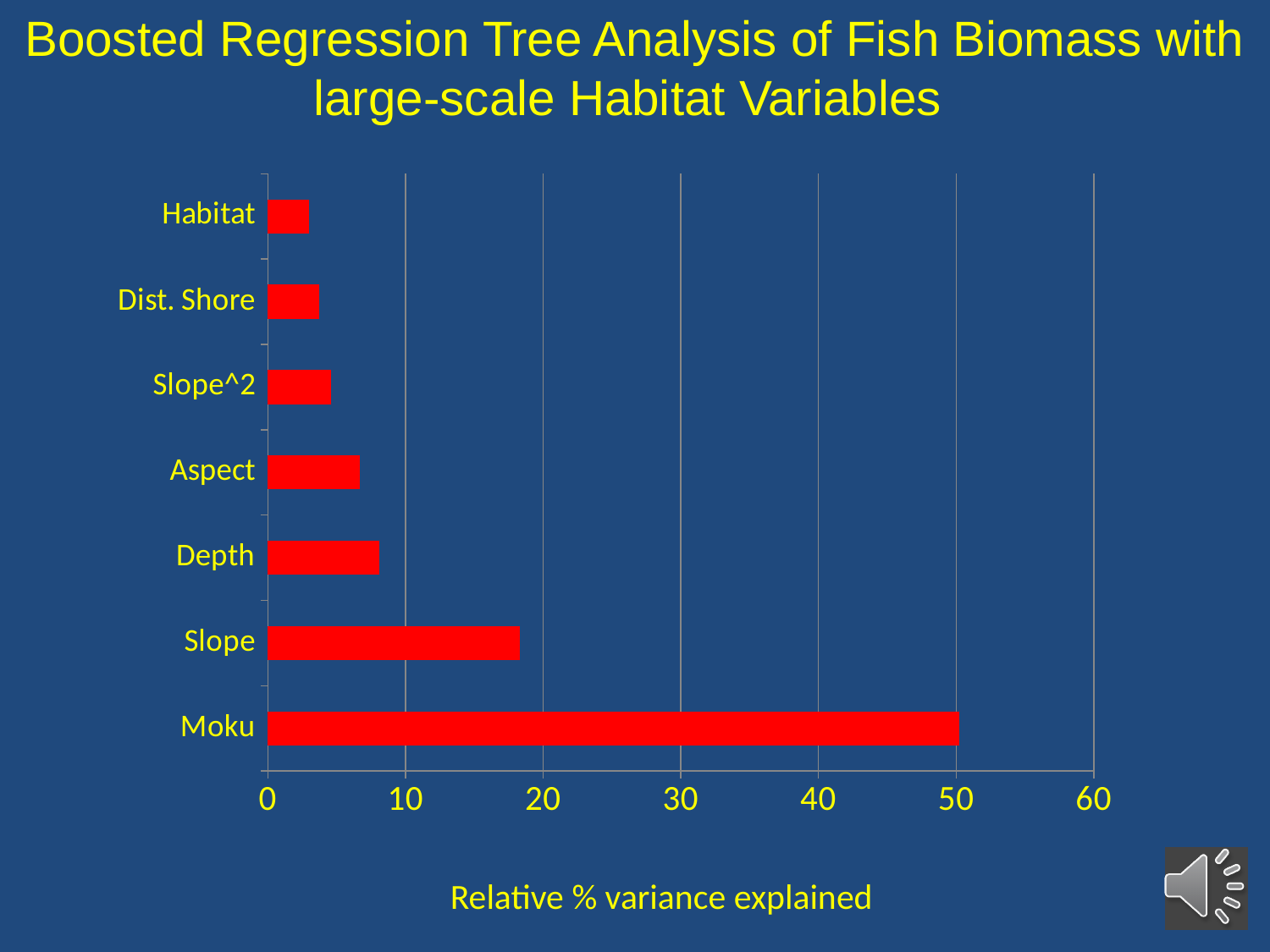
Which has a larger value, Moku or Slope? Moku Which has a larger value, Slope or Depth? Slope Is the value for Slope greater or less than 20? less Which variable has the highest relative % variance explained? Moku Which has a larger value, Aspect or Slope^2? Aspect What is the label on the horizontal axis of the chart? Relative % variance explained Is the value for Slope greater or less than 10? greater What colour are the bars in the chart? Red How many categories (variables) are plotted in the chart? 7 What kind of chart is shown on the slide? Bar chart Is the value for Depth greater or less than 10? less